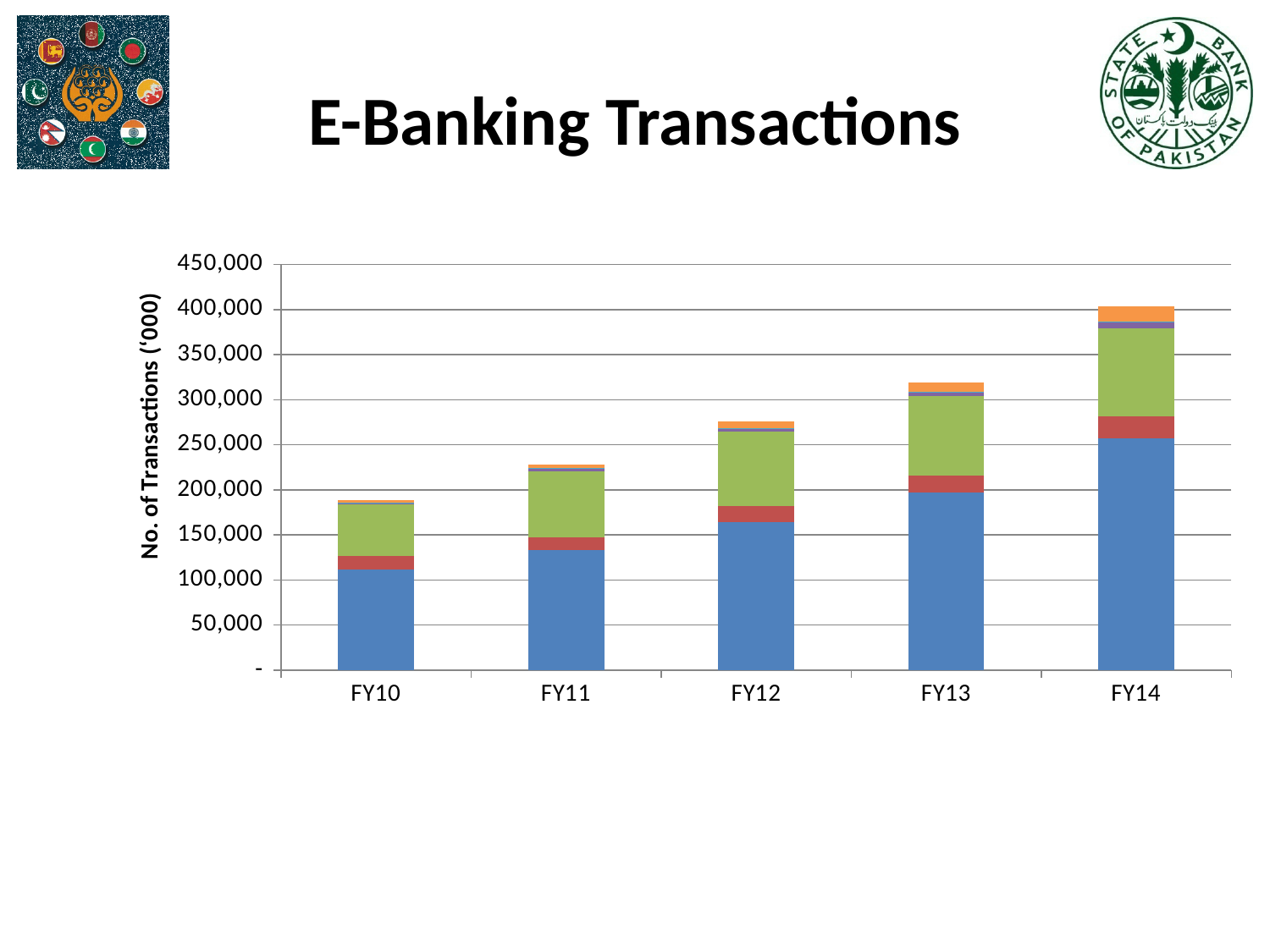
Is the total bar for FY10 greater or less than 200,000? less Which fiscal year has the lowest total number of e-banking transactions? FY10 Which fiscal year has the highest total number of e-banking transactions? FY14 Is the total bar for FY13 greater or less than 300,000? greater Which is larger, the total bar for FY12 or the total bar for FY13? FY13 Is the total bar for FY12 greater or less than 250,000? greater What is the label on the vertical axis of the chart? No. of Transactions ('000) Do the total e-banking transactions rise or fall from FY10 to FY14? Rise What kind of chart is shown on the slide? Stacked bar chart How many fiscal years are shown on the x axis of the chart? 5